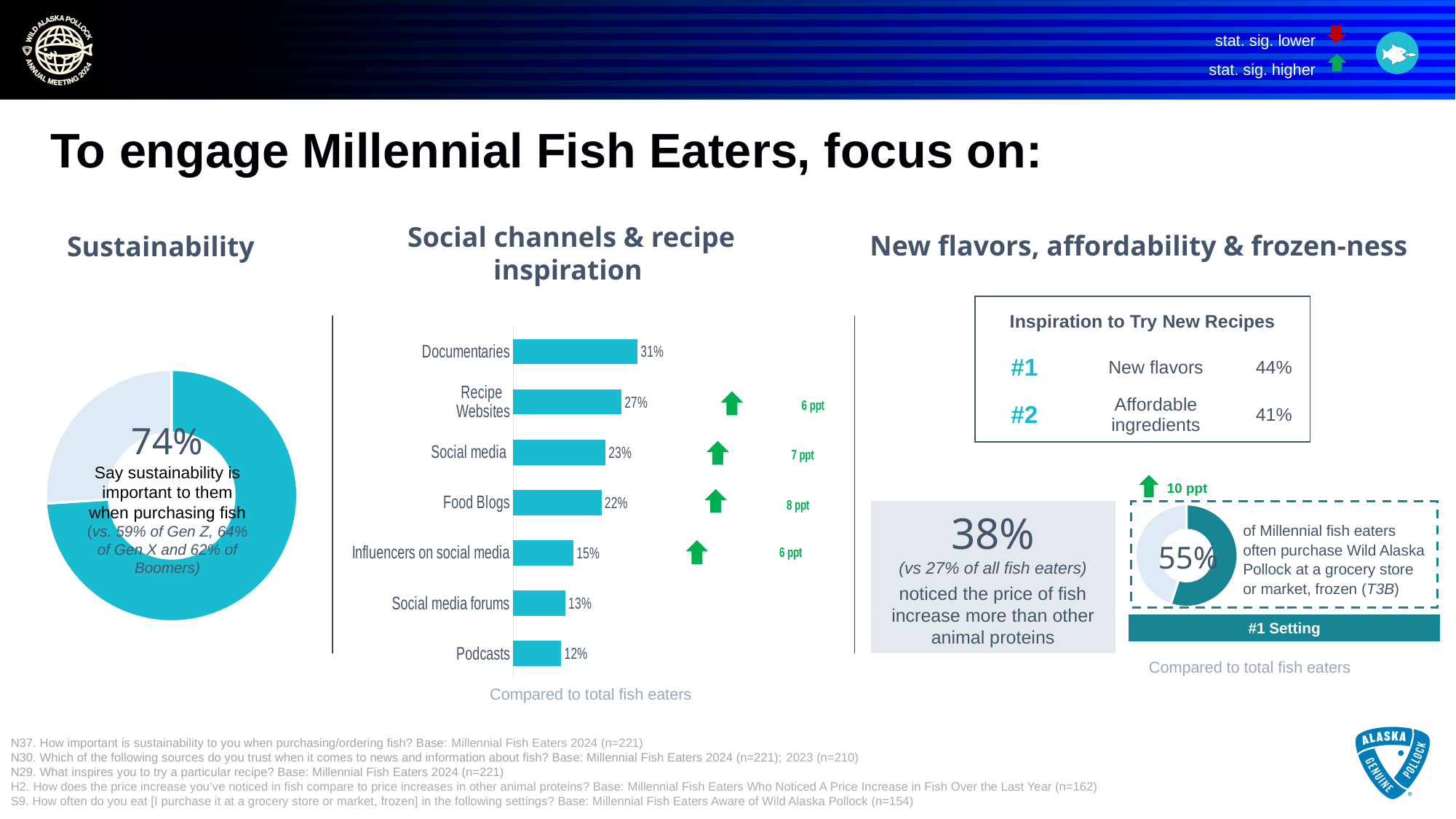
In the bar chart under 'Social channels & recipe inspiration', which is larger: Social media or Influencers on social media? Social media In the donut chart under 'Sustainability', what percentage say sustainability is important to them when purchasing fish? 74% What kind of chart is shown under 'Social channels & recipe inspiration'? Bar chart In the bar chart under 'Social channels & recipe inspiration', what is the value for Documentaries? 31% In the bar chart under 'Social channels & recipe inspiration', what is the difference between Recipe Websites and Social media forums? 14% How many categories are shown in the bar chart under 'Social channels & recipe inspiration'? 7 In the bar chart under 'Social channels & recipe inspiration', which category has the lowest value? Podcasts In the donut chart on the right under 'New flavors, affordability & frozen-ness', what percentage of Millennial fish eaters often purchase Wild Alaska Pollock at a grocery store or market, frozen? 55% In the bar chart under 'Social channels & recipe inspiration', which category has the highest value? Documentaries What kind of chart is shown under 'Sustainability'? Donut chart In the bar chart under 'Social channels & recipe inspiration', what is the value for Food Blogs? 22% In the bar chart under 'Social channels & recipe inspiration', what is the value for Podcasts? 12%